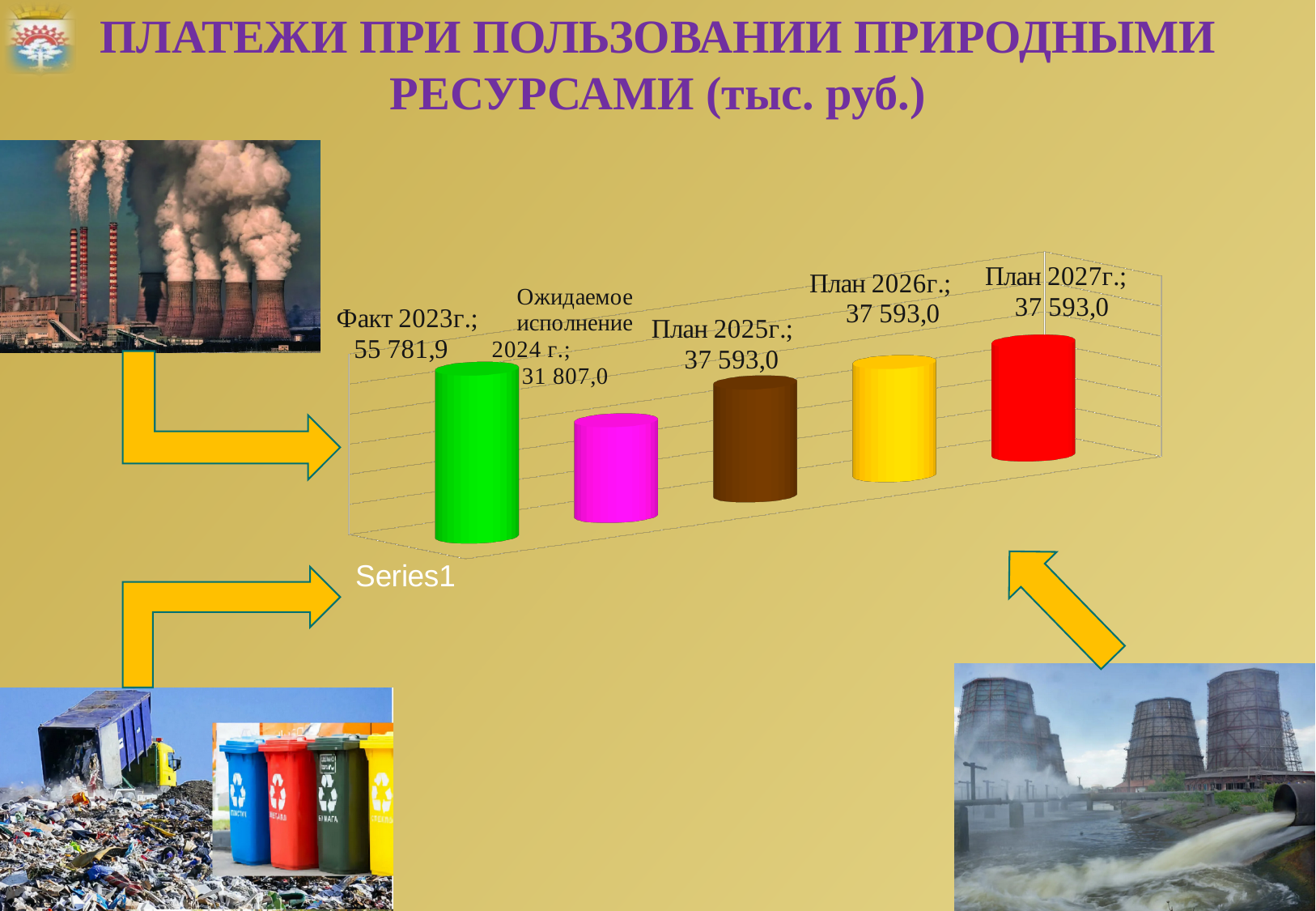
How many categories are shown in the chart? 5 What is the value for Ожидаемое исполнение 2024 г.? 31 807,0 What is the value for План 2027г.? 37 593,0 What kind of chart is shown on the slide? Bar chart Which is larger, the value for Факт 2023г. or the value for План 2026г.? Факт 2023г. What is the difference between the value for Факт 2023г. and the value for Ожидаемое исполнение 2024 г.? 23 974,9 What is the value for План 2025г.? 37 593,0 Which category has the highest value? Факт 2023г. Which category has the lowest value? Ожидаемое исполнение 2024 г. Does the value rise or fall from Факт 2023г. to Ожидаемое исполнение 2024 г.? Fall What is the difference between the value for План 2025г. and the value for Ожидаемое исполнение 2024 г.? 5 786,0 What is the value for Факт 2023г.? 55 781,9